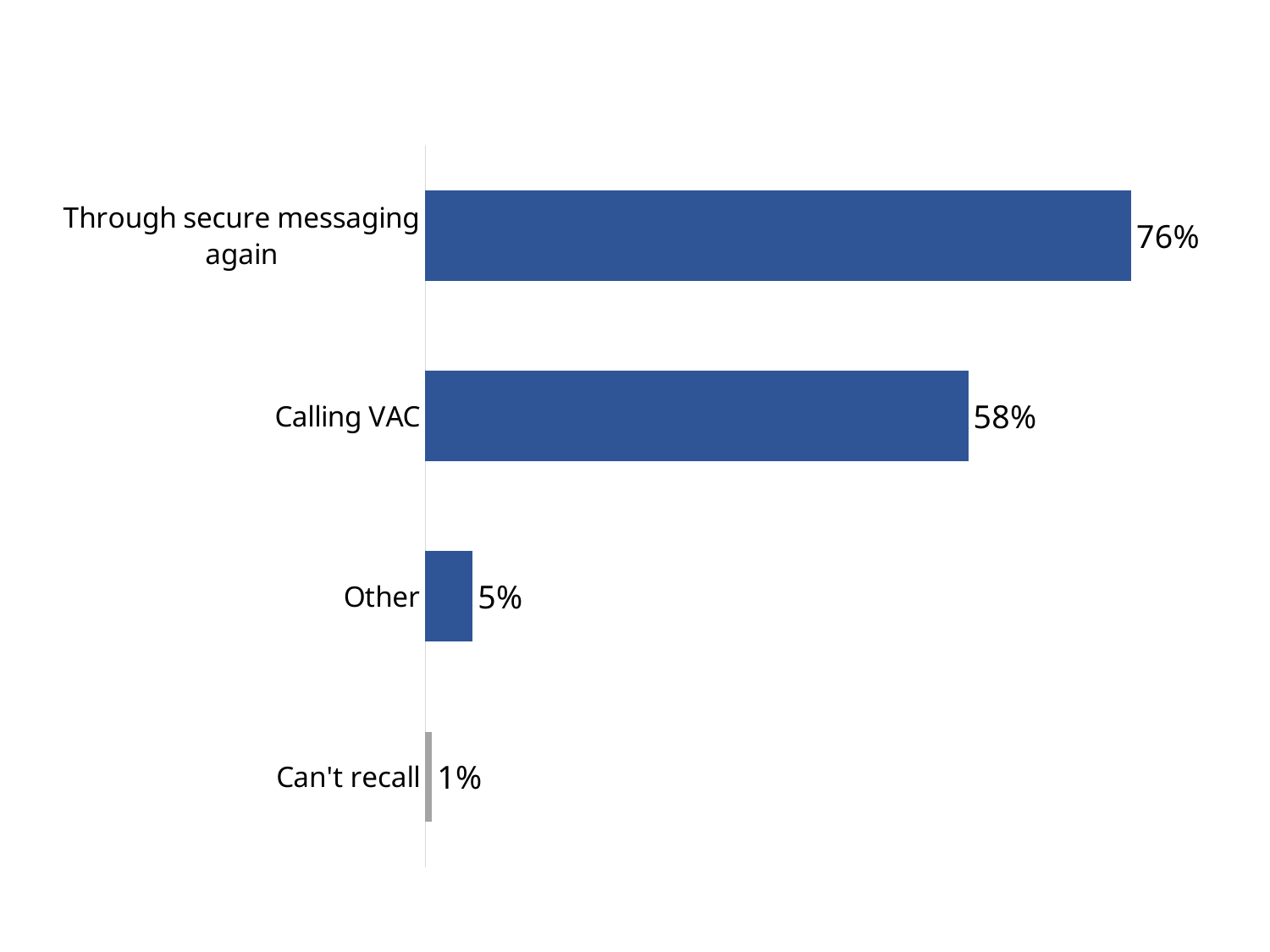
What is the difference between the values for "Other" and "Can't recall"? 4% Which category has the lowest value? Can't recall What is the value for "Through secure messaging again"? 76% Which is larger, the value for "Calling VAC" or the value for "Other"? Calling VAC What is the difference between the values for "Through secure messaging again" and "Calling VAC"? 18% What is the value for "Can't recall"? 1% What is the value for "Other"? 5% What is the value for "Calling VAC"? 58% How many categories are shown in the chart? 4 What kind of chart is shown on the slide? Bar chart Which bar is coloured grey rather than blue? Can't recall Which category has the highest value? Through secure messaging again